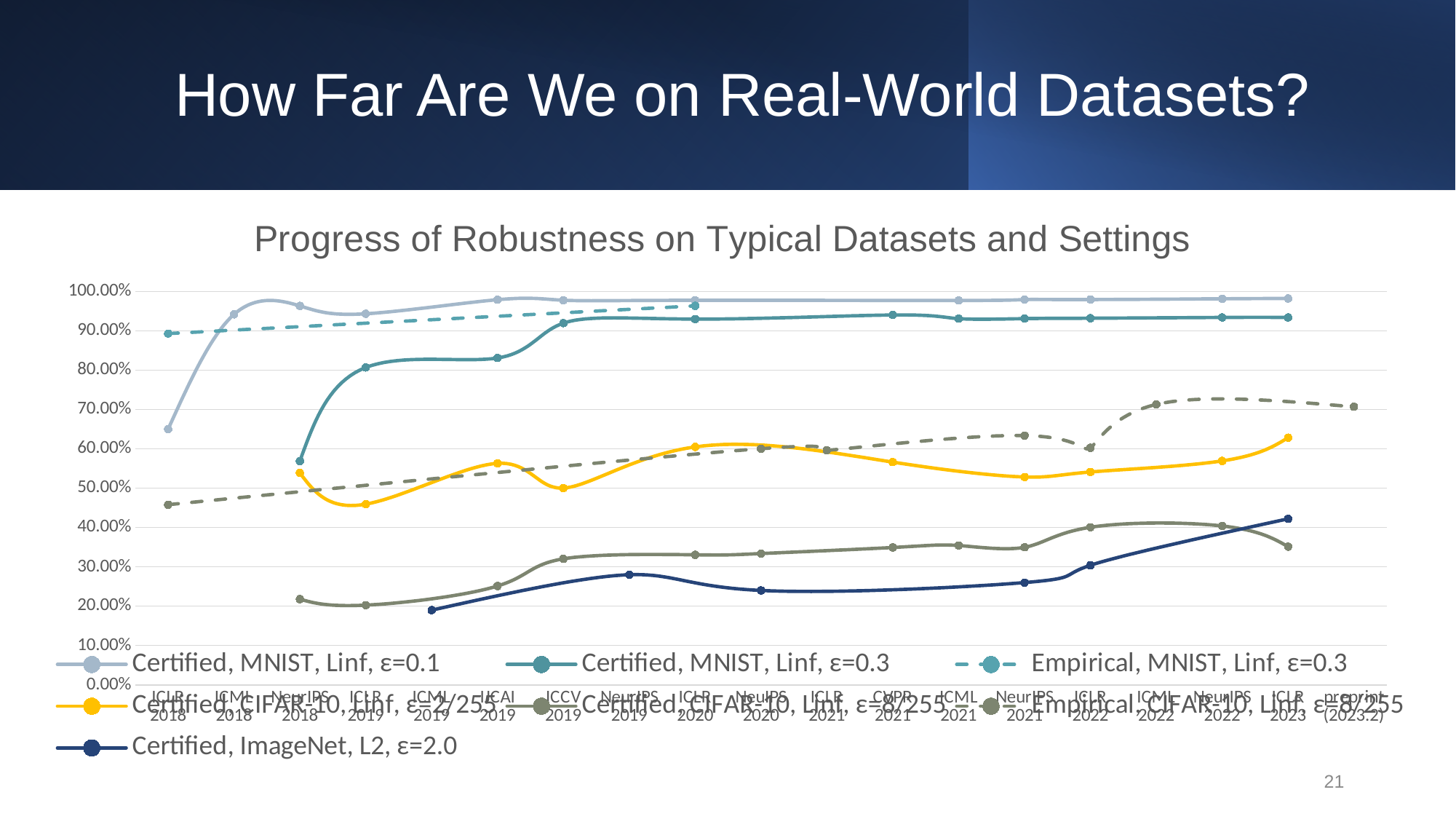
At ICLR 2023, which is larger: Certified, MNIST, Linf, ε=0.3 or Certified, CIFAR-10, Linf, ε=2/255? Certified, MNIST, Linf, ε=0.3 Which series has the lowest value at ICLR 2018? Empirical, CIFAR-10, Linf, ε=8/255 How many series does the chart legend list? 7 Is the value for Certified, MNIST, Linf, ε=0.1 at ICLR 2018 greater or less than 60.00%? greater What is the title of the chart? Progress of Robustness on Typical Datasets and Settings Is the value for Certified, CIFAR-10, Linf, ε=8/255 at NeurIPS 2018 greater or less than 30.00%? less Is the value for Empirical, CIFAR-10, Linf, ε=8/255 at ICLR 2018 greater or less than 50.00%? less How many venue/year categories are shown along the x axis? 19 Which series has the highest value at ICLR 2023? Certified, MNIST, Linf, ε=0.1 Does the Certified, ImageNet, L2, ε=2.0 series generally rise or fall from ICML 2019 to ICLR 2023? Rise What kind of chart is shown on the slide? Line chart